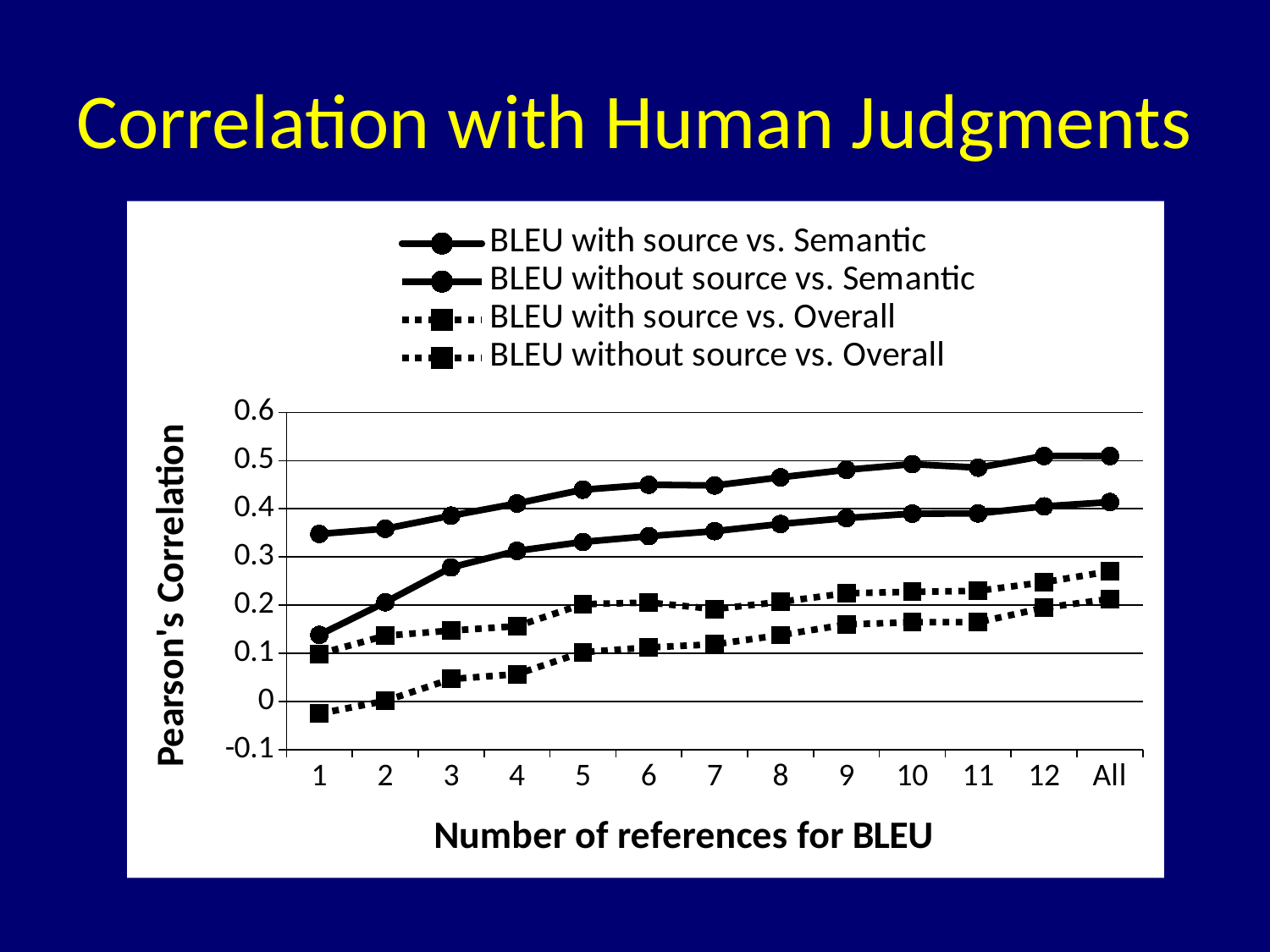
Is the highest plotted value at 1 reference greater or less than 0.3? greater Is the lowest plotted value at 1 reference greater or less than 0.1? less What is the label of the y axis? Pearson's Correlation Is the lowest plotted value at All references greater or less than 0.3? less What kind of chart is shown on the slide? line chart Do the plotted values generally rise or fall as the number of references increases? rise How many series does the legend list? 4 How many categories are shown along the x axis? 13 What is the title of the slide containing the chart? Correlation with Human Judgments Are the solid-line series (vs. Semantic) plotted higher or lower than the dotted-line series (vs. Overall)? higher What is the last category label on the x axis? All